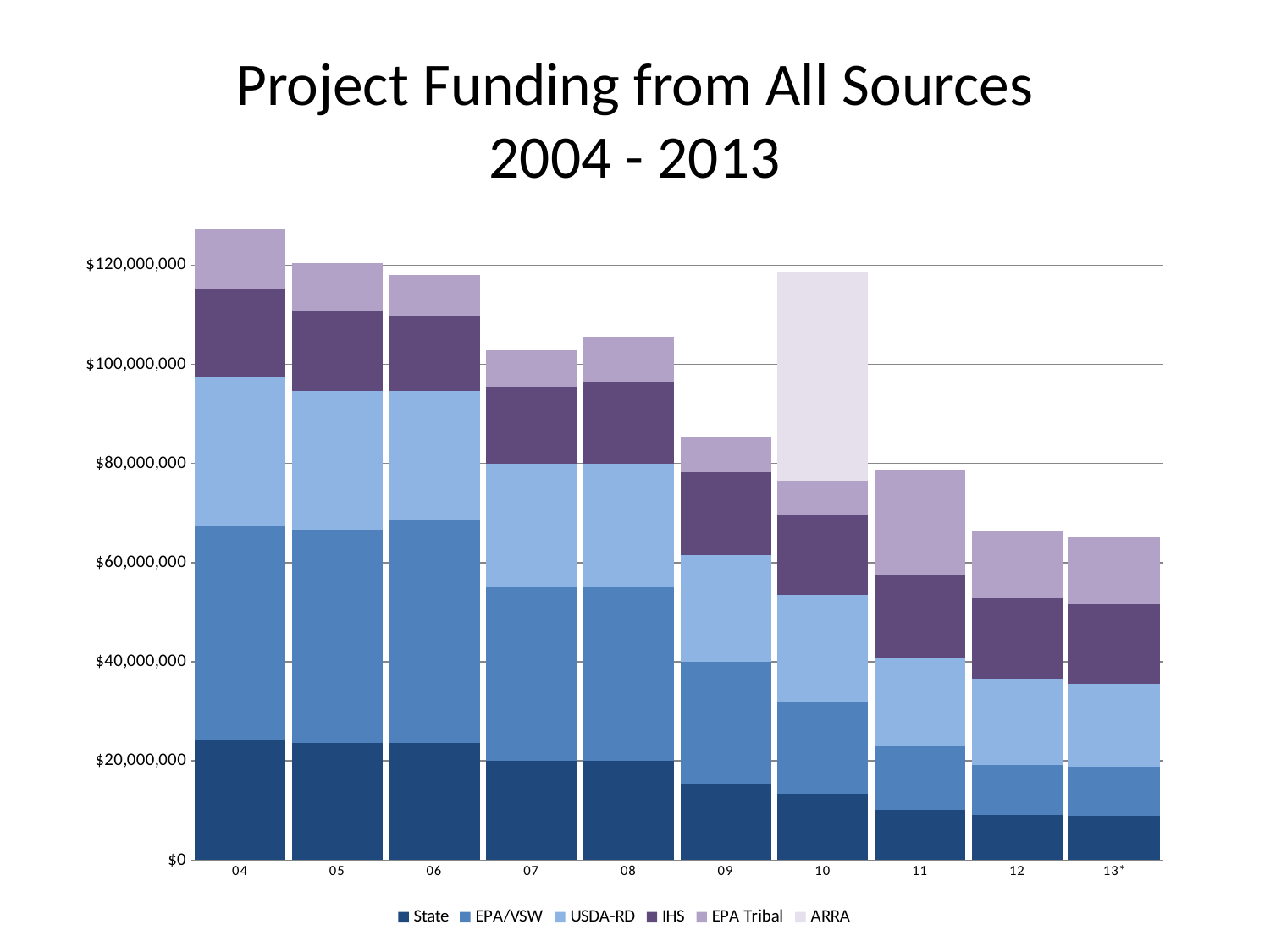
Is the total funding for 04 greater or less than $120,000,000? greater Overall, does total project funding rise or fall from 04 to 13*? fall Is the total funding for 09 greater or less than $100,000,000? less Is the State funding for 13* greater or less than $20,000,000? less How many years (bars) are shown on the x axis? 10 Which year has the highest total project funding? 04 Which year has larger total funding, 09 or 10? 10 What kind of chart is shown on the slide? Stacked bar chart How many series does the legend list? 6 In which year does the ARRA series appear? 10 Which year has larger State funding, 04 or 10? 04